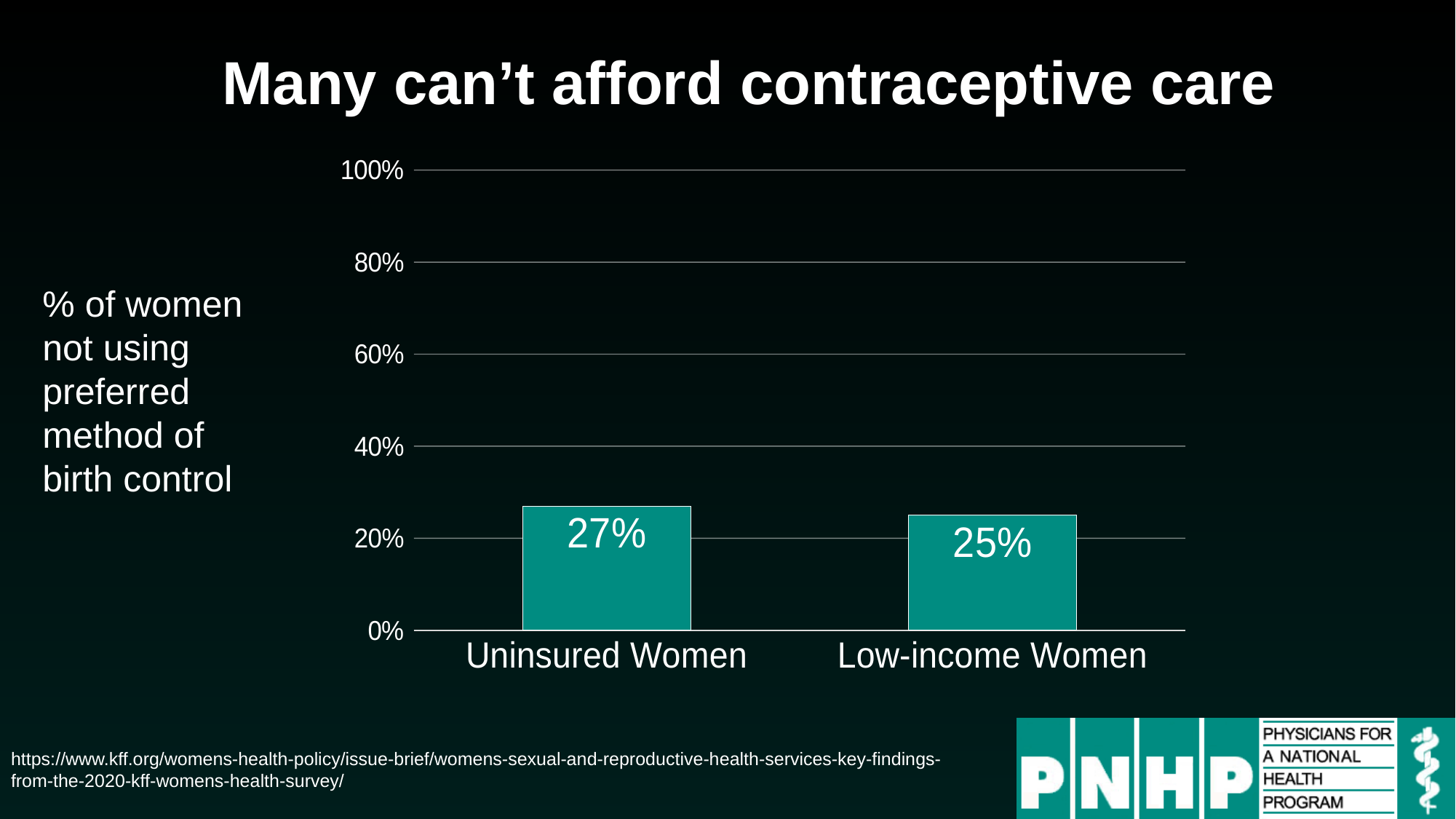
What is the difference between the values for Uninsured Women and Low-income Women? 2% What is the title of the slide? Many can't afford contraceptive care How many categories are shown on the chart? 2 What percentage of low-income women are not using their preferred method of birth control? 25% What is the highest value shown on the y axis? 100% What percentage of uninsured women are not using their preferred method of birth control? 27% Is the value for Low-income Women greater or less than 20%? greater Which category has the lower value? Low-income Women Is the value for Uninsured Women greater or less than 40%? less Which category has the higher value, Uninsured Women or Low-income Women? Uninsured Women What kind of chart is shown on the slide? bar chart